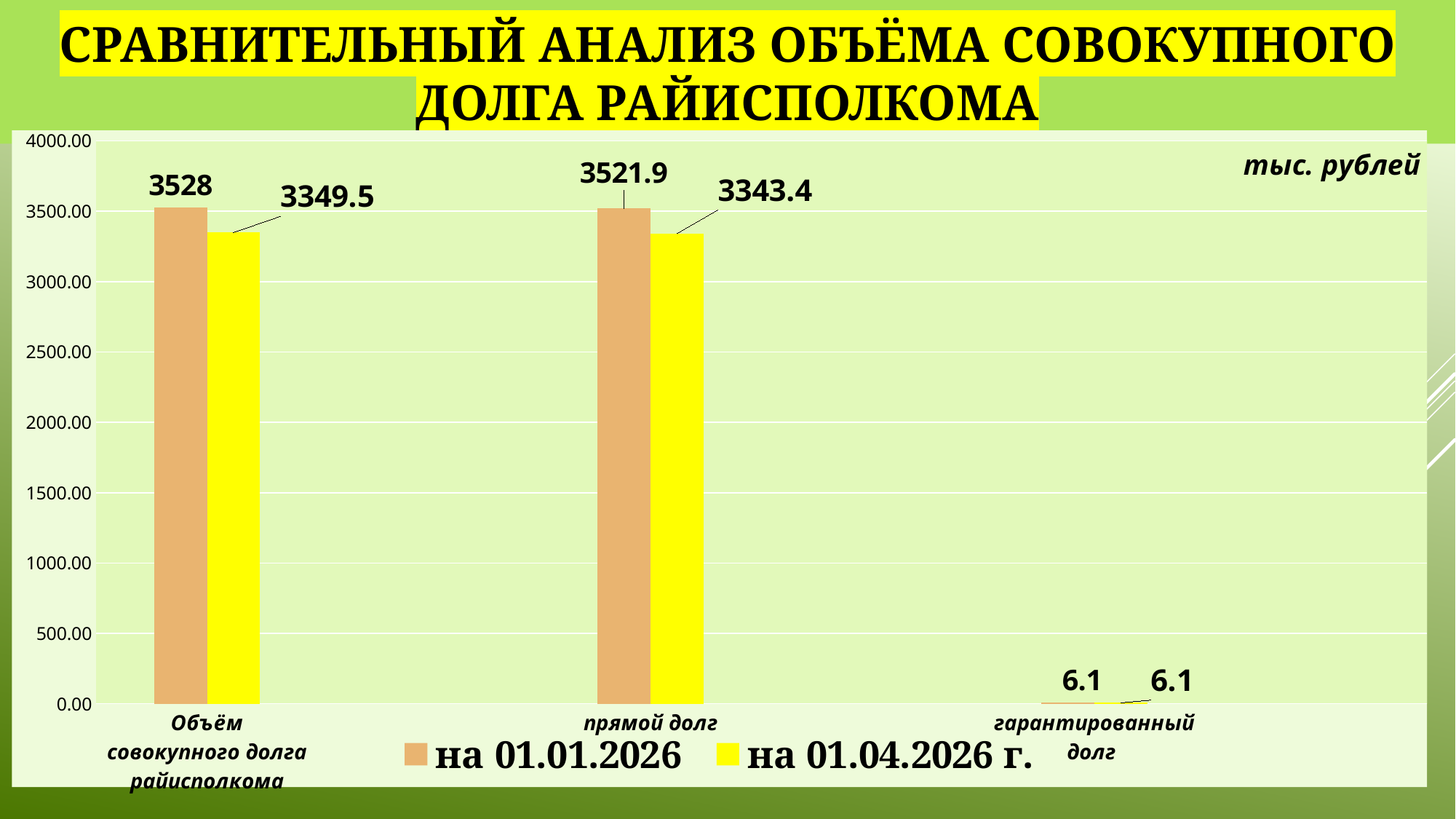
How many series does the legend list? 2 What is the value for «прямой долг» in the series «на 01.01.2026»? 3521.9 Which category has the highest value in the series «на 01.04.2026 г.»? Объём совокупного долга райисполкома What is the difference between the «на 01.01.2026» and «на 01.04.2026 г.» values for «прямой долг»? 178.5 For «Объём совокупного долга райисполкома», which series has the larger value: «на 01.01.2026» or «на 01.04.2026 г.»? на 01.01.2026 What kind of chart is shown on the slide? bar chart What is the value for «Объём совокупного долга райисполкома» in the series «на 01.01.2026»? 3528 What is the value for «прямой долг» in the series «на 01.04.2026 г.»? 3343.4 What is the value for «Объём совокупного долга райисполкома» in the series «на 01.04.2026 г.»? 3349.5 Which category has the lowest value in the series «на 01.01.2026»? гарантированный долг How many categories are shown on the x axis of the chart? 3 What is the value for «гарантированный долг» in the series «на 01.04.2026 г.»? 6.1